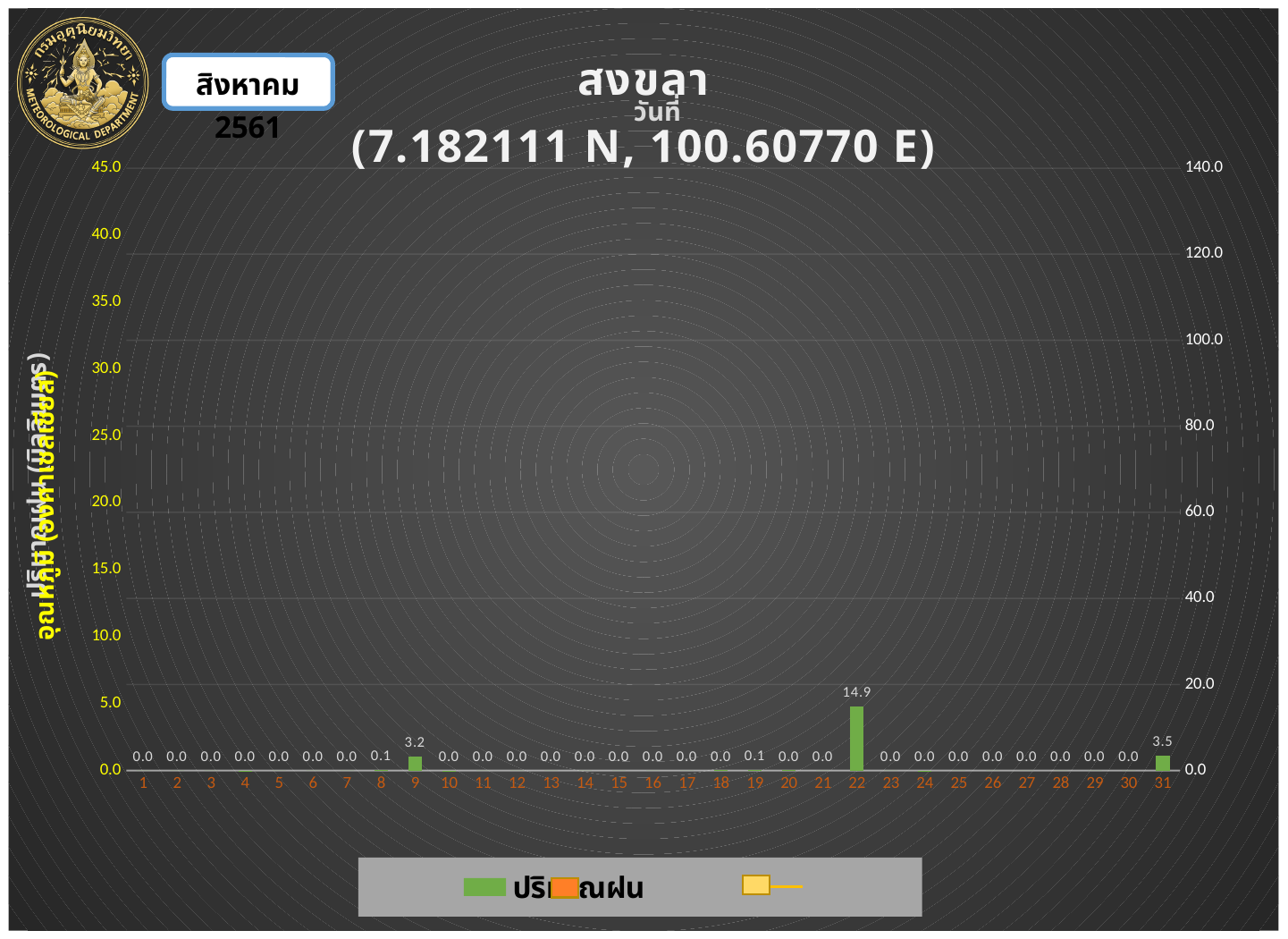
What is the value shown for day 8? 0.1 Which day has the highest value? 22 How many days are shown on the x axis? 31 What is the rainfall value shown for day 22? 14.9 What is the difference between the values for day 22 and day 9? 11.7 What is the value shown for day 31? 3.5 What is the value shown for day 9? 3.2 What is the difference between the values for day 31 and day 9? 0.3 Which day has the larger value, day 9 or day 31? 31 What is the value shown for day 19? 0.1 What is the station name in the chart title? สงขลา What kind of chart is shown? bar chart